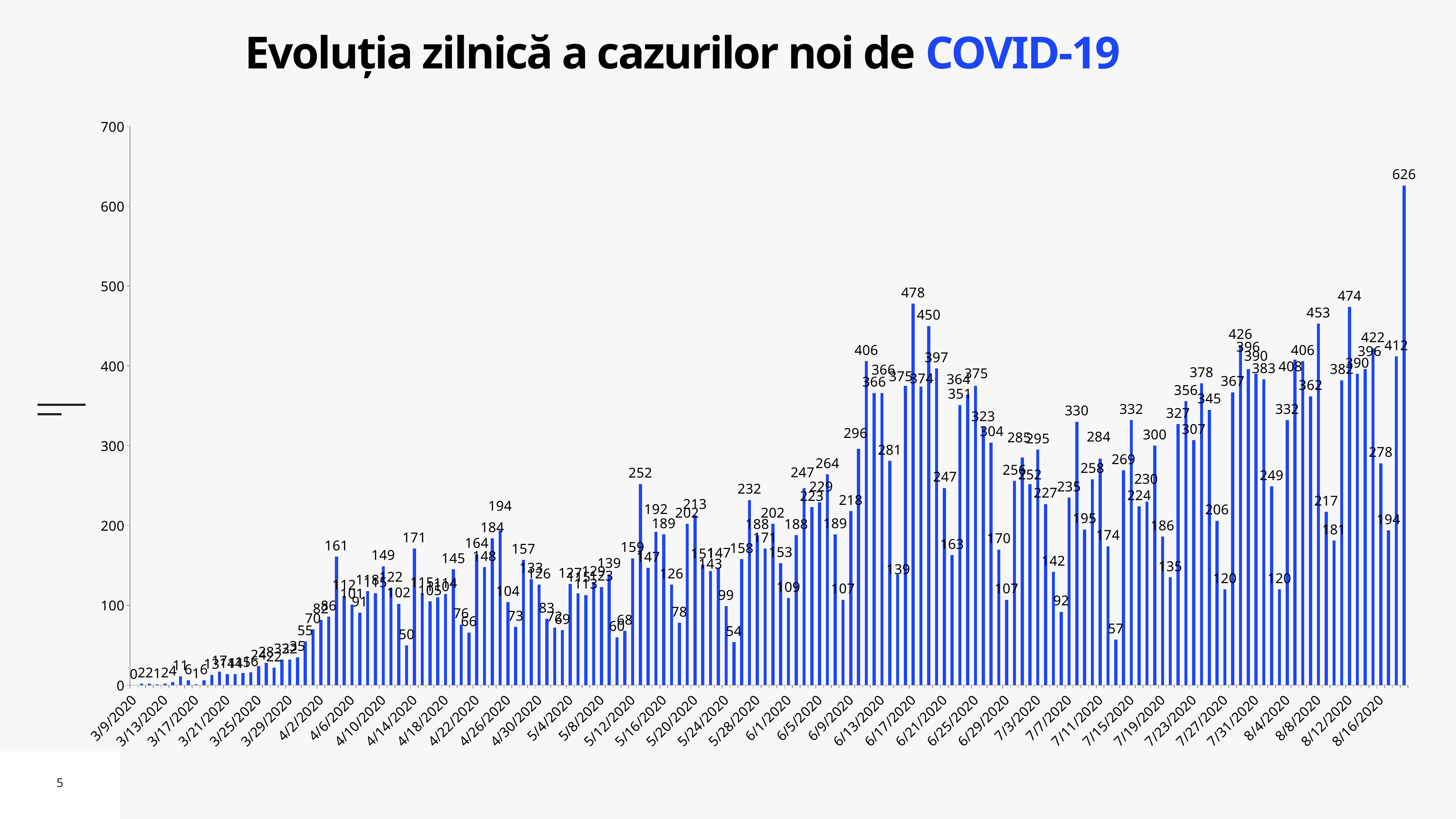
How many bars on the chart exceed 600? 1 Is the tallest bar on the chart greater or less than 600? greater What is the title of the chart on the slide? Evoluția zilnică a cazurilor noi de COVID-19 Which is larger, the value of the first bar (3/9/2020) or the value of the last bar? the last bar Is the bar labelled 478 greater or less than 500? less What is the value of the first bar, for 3/9/2020? 0 What is the difference between the highest value (626) and the second highest value (478)? 148 Overall, do the daily values rise or fall from March to August along the x axis? rise What is the highest daily value shown on the chart? 626 What is the second highest data label shown on the chart? 478 What is the maximum value shown on the vertical axis? 700 What kind of chart is shown on the slide? bar chart